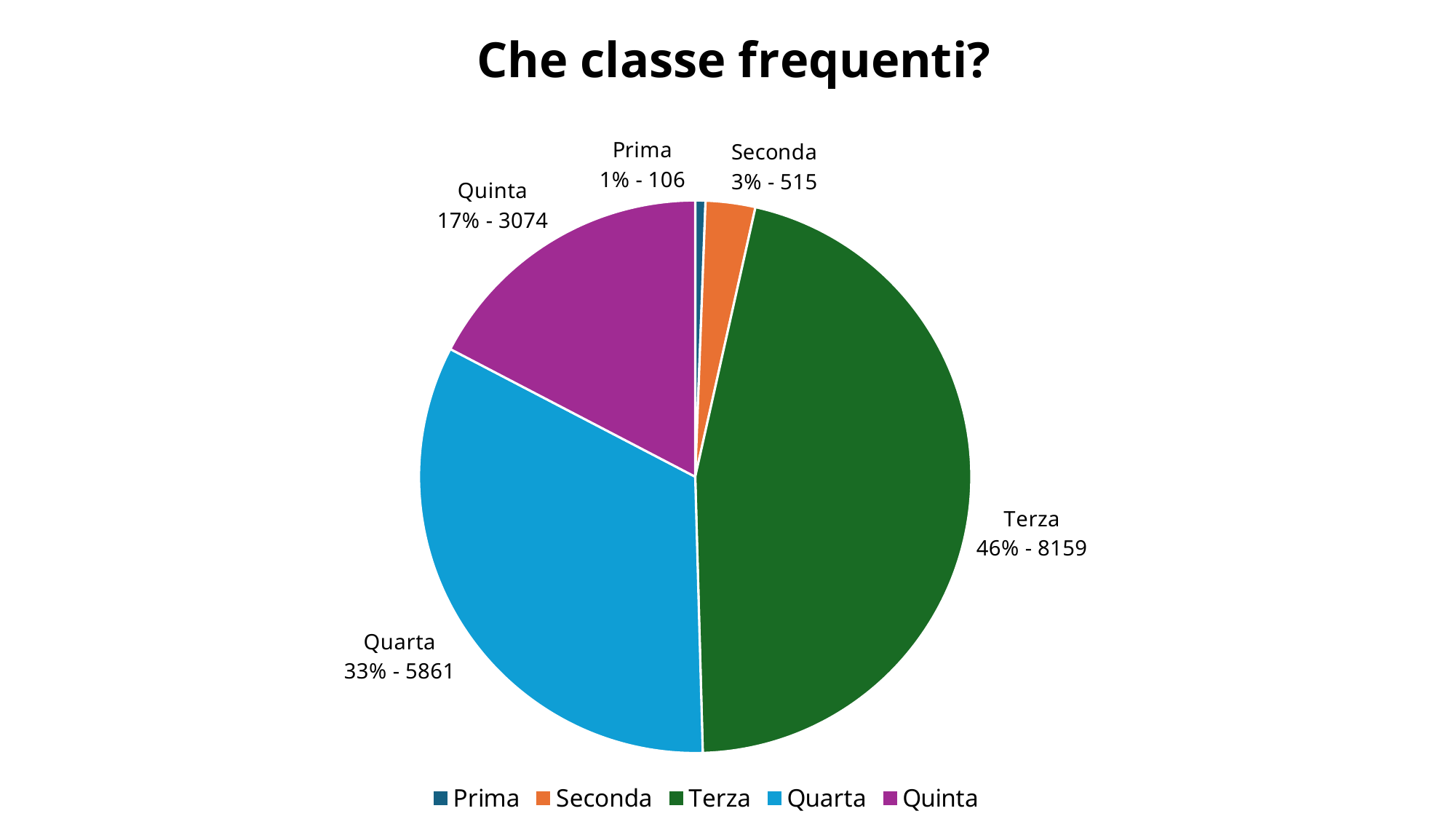
What is the count shown for Quinta? 3074 How many slices does the pie chart have? 5 Which class has the smallest slice? Prima What is the difference in count between Terza and Quarta? 2298 What percentage share does Prima have? 1% How many entries does the legend list? 5 What is the count shown for Terza? 8159 What kind of chart is shown on the slide? pie chart Which has a larger count, Seconda or Quinta? Quinta Which class has the largest slice? Terza What is the title of the chart? Che classe frequenti? What percentage share does Quarta have? 33%